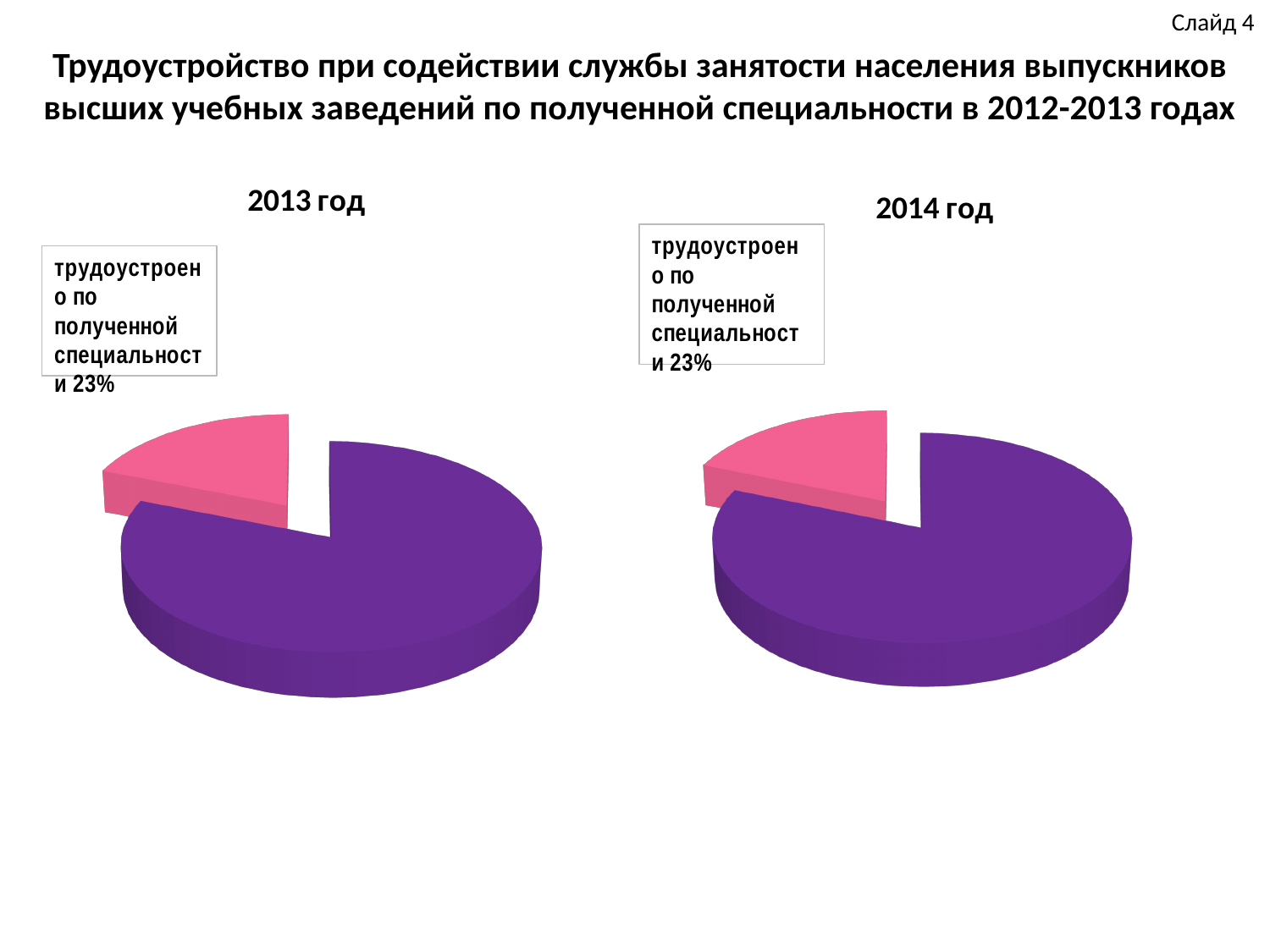
What kind of chart is the "2014 год" chart? pie chart How many slices does the "2014 год" pie chart have? 2 What kind of chart is the "2013 год" chart? pie chart In the "2014 год" chart, what share of the pie is labelled "трудоустроено по полученной специальности"? 23% How many slices does the "2013 год" pie chart have? 2 In the "2013 год" chart, is the share for "трудоустроено по полученной специальности" greater or less than 50%? less In the "2014 год" chart, is the share for "трудоустроено по полученной специальности" greater or less than 50%? less In the "2013 год" chart, which slice is larger, the pink one or the purple one? the purple one Is the share for "трудоустроено по полученной специальности" in the "2013 год" chart larger, smaller or the same as in the "2014 год" chart? the same In the "2013 год" chart, what share of the pie is labelled "трудоустроено по полученной специальности"? 23% How many pie charts are shown on the slide? 2 What colour is the slice labelled "трудоустроено по полученной специальности" in the "2014 год" chart? pink